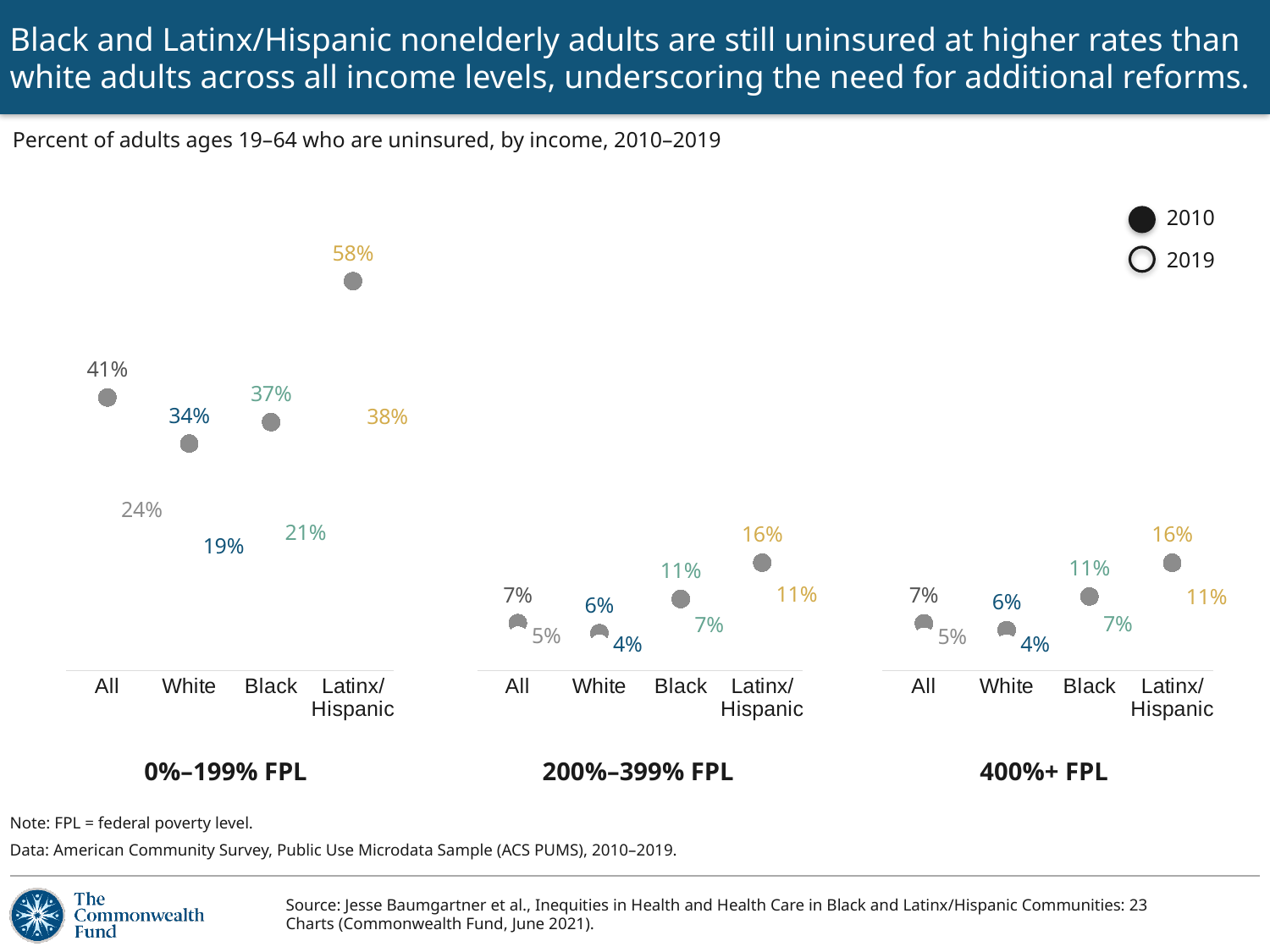
How many series does the legend list? 2 In the 0%–199% FPL chart, what is the difference between the 2010 and 2019 uninsured rates for All adults? 17 percentage points In the 200%–399% FPL chart, which group had the lowest uninsured rate in 2019? White In the 200%–399% FPL chart, what was the uninsured rate for Black adults in 2010? 11% In the 0%–199% FPL chart, what was the uninsured rate for Latinx/Hispanic adults in 2010? 58% In the 0%–199% FPL chart, what was the uninsured rate for White adults in 2019? 19% How many groups are shown on the x axis of the 200%–399% FPL chart? 4 In the 400%+ FPL chart, what was the uninsured rate for Latinx/Hispanic adults in 2019? 11% In the 0%–199% FPL chart, which group had the highest uninsured rate in 2010? Latinx/Hispanic In the 0%–199% FPL chart, which was higher in 2010: the uninsured rate for Black adults or for White adults? Black Which legend entry is shown as a filled circle? 2010 In the 400%+ FPL chart, what is the difference between the 2010 uninsured rates for Latinx/Hispanic and White adults? 10 percentage points